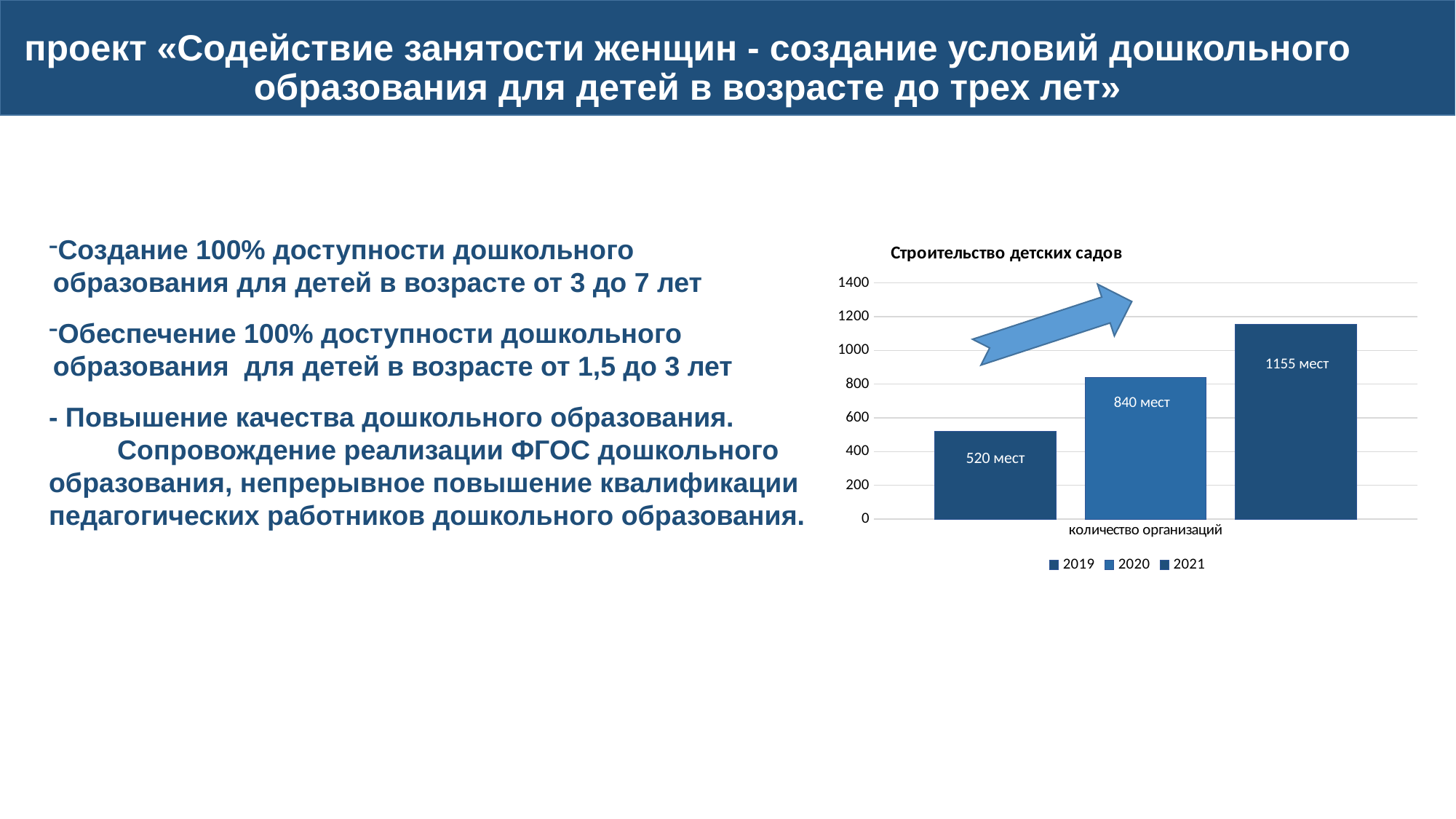
Which is larger, the value for 2019 or the value for 2020? 2020 Which year has the lowest value in the chart? 2019 What is the value for 2021 in the chart? 1155 мест What is the value for 2020 in the chart? 840 мест Is the value for 2021 greater or less than 1000? greater What is the difference between the values for 2021 and 2020? 315 мест What is the title of the chart? Строительство детских садов How many series does the legend list? 3 What is the difference between the values for 2020 and 2019? 320 мест What kind of chart is shown on the slide? bar chart What is the value for 2019 in the chart? 520 мест Which year has the highest value in the chart? 2021